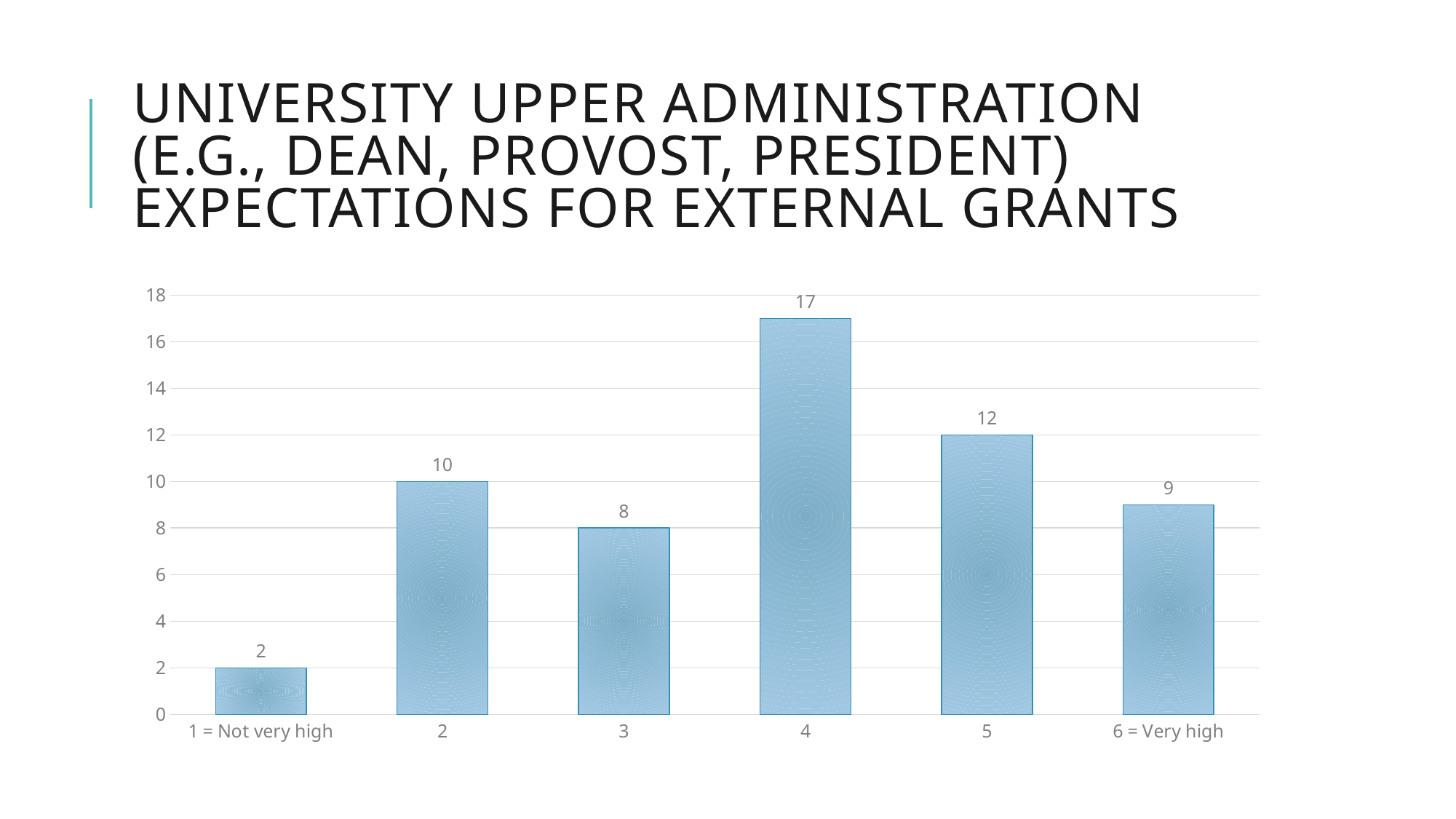
Which is larger, the value for category 2 or the value for category 3? 2 Is the value for category 5 greater or less than 10? greater What is the value for the category '1 = Not very high'? 2 What is the title of the slide? University Upper Administration (e.g., Dean, Provost, President) Expectations for External Grants What kind of chart is shown on the slide? bar chart What is the value for the category '6 = Very high'? 9 Which category has the lowest value? 1 = Not very high What is the value for category 4? 17 How many categories are shown on the x axis? 6 Which category has the highest value? 4 What is the difference between the values for category 4 and category 5? 5 What is the total of all the bar values in the chart? 58